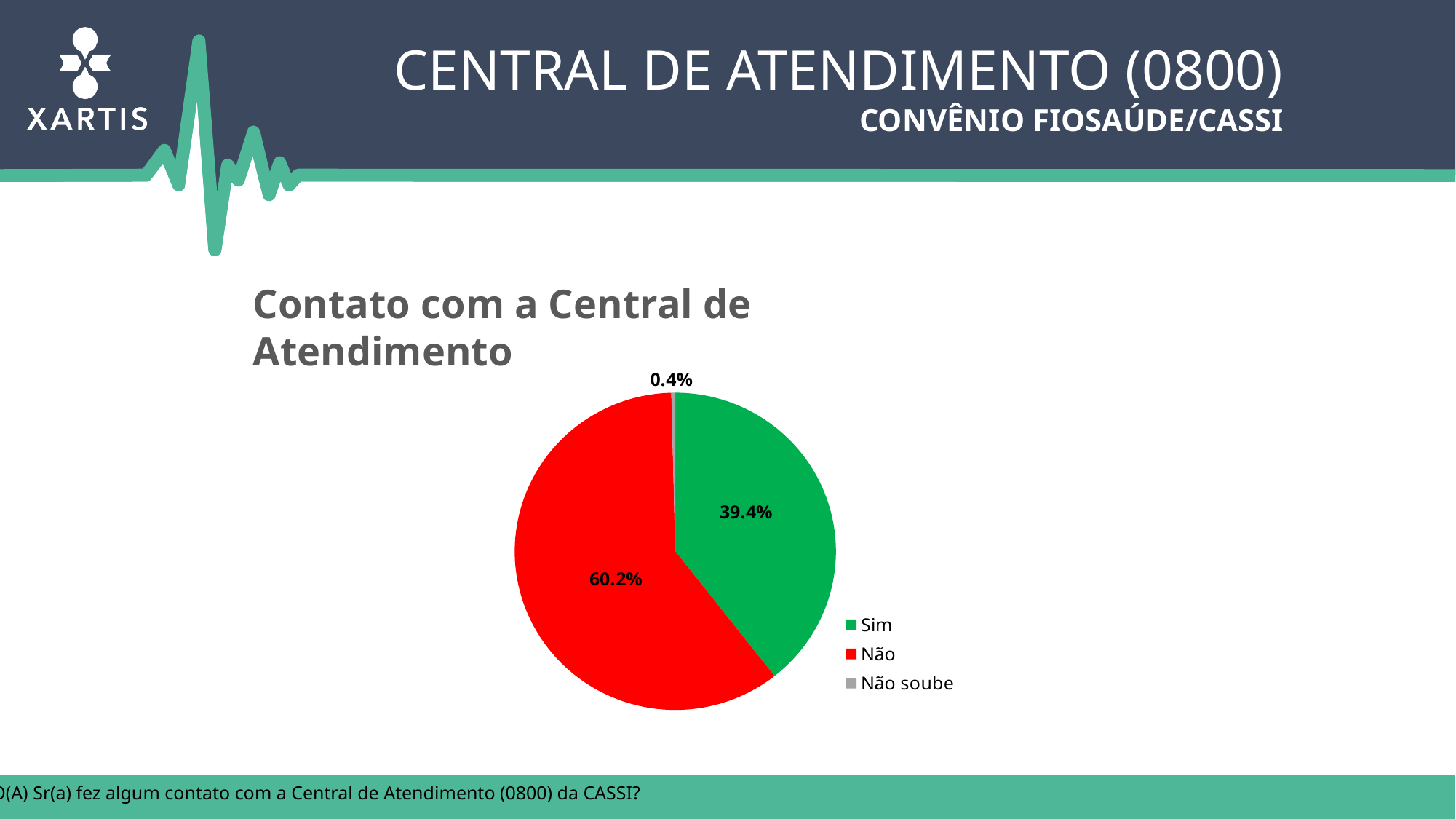
Which slice is larger, 'Sim' or 'Não'? Não Which category has the largest share of the pie chart? Não What percentage of the pie chart is the 'Sim' slice? 39.4% What colour is the 'Não' slice in the pie chart? Red How many categories are shown in the pie chart? 3 What percentage of the pie chart is the 'Não' slice? 60.2% What percentage of the pie chart is the 'Não soube' slice? 0.4% What type of chart is shown on the slide? Pie chart What is the difference in percentage points between the 'Não' and 'Sim' slices? 20.8 What is the title of the chart? Contato com a Central de Atendimento Which category has the smallest share of the pie chart? Não soube What is the combined share of the 'Sim' and 'Não soube' slices? 39.8%